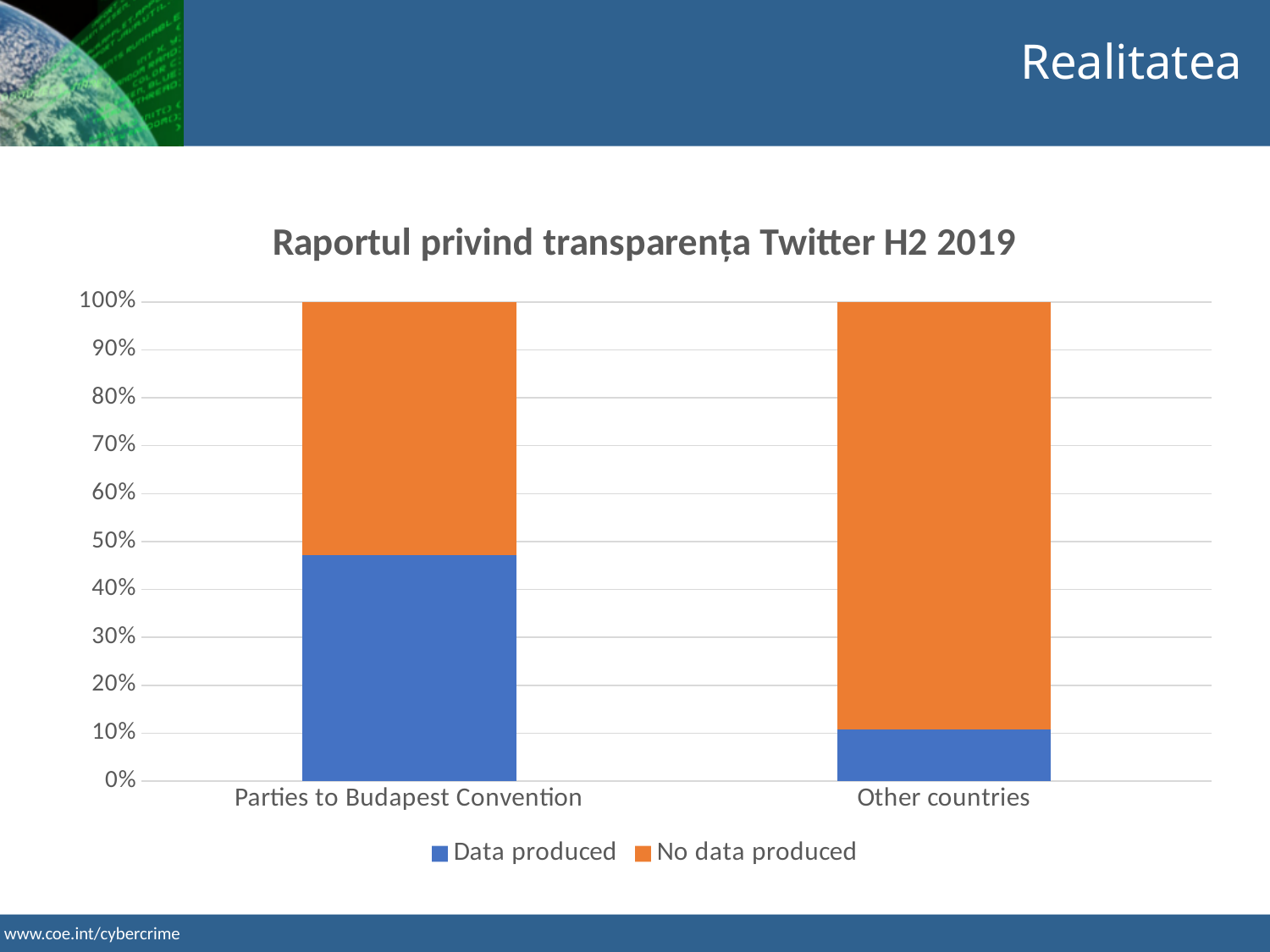
How many series does the legend list? 2 How many categories are shown on the x axis? 2 Which series is shown in orange? No data produced Is the 'Data produced' share for Other countries greater or less than 20%? less What is the total of the stacked bar for Other countries? 100% Is the 'Data produced' share for Parties to Budapest Convention greater or less than 50%? less Which category has the larger 'Data produced' share, Parties to Budapest Convention or Other countries? Parties to Budapest Convention Which category has the larger 'No data produced' share? Other countries Is the 'No data produced' share for Other countries greater or less than 80%? greater What kind of chart is shown on the slide? Stacked bar chart What is the title of the chart? Raportul privind transparența Twitter H2 2019